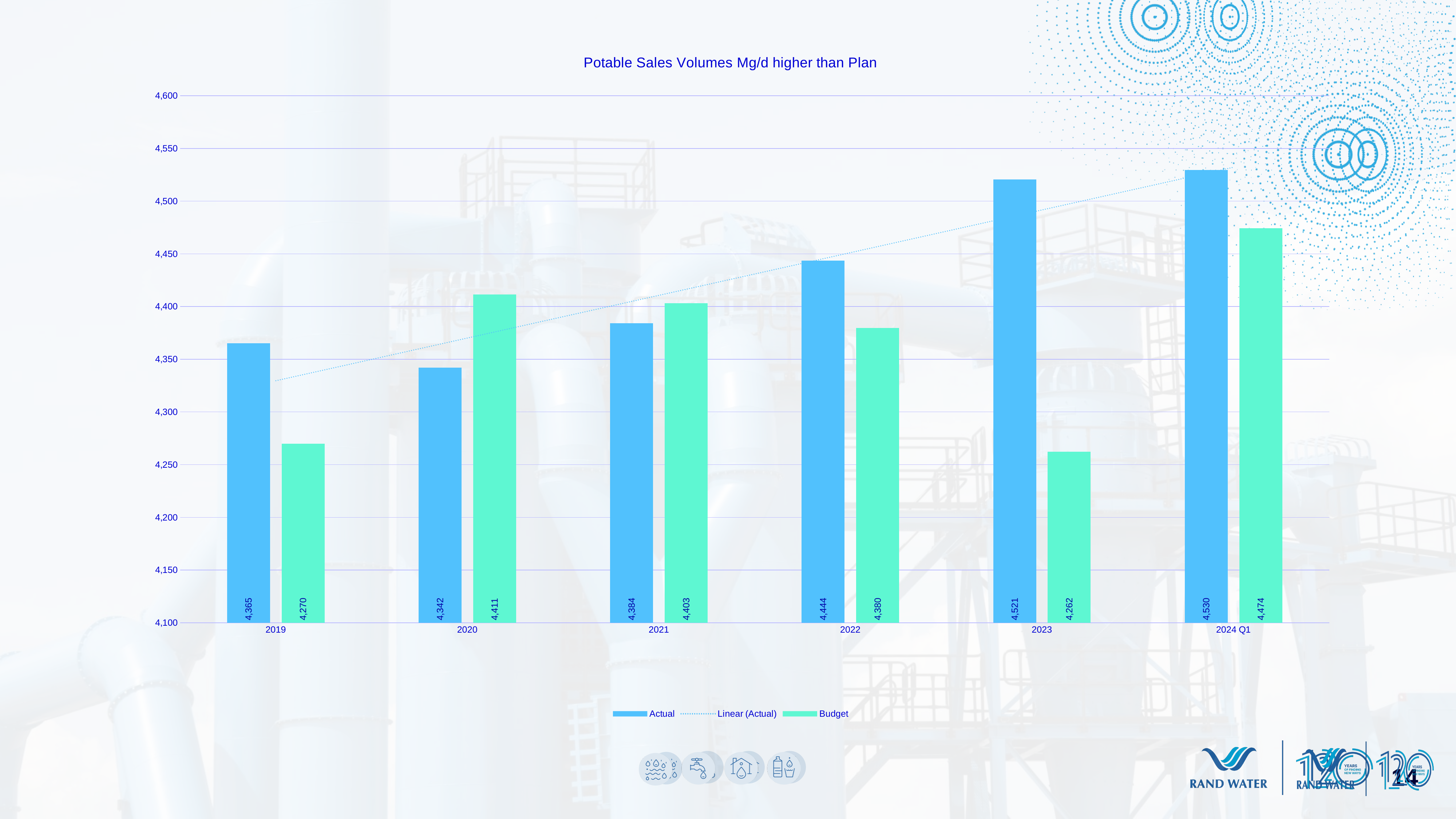
What kind of chart is shown on the slide? bar chart Which is larger for 2021, the Actual value or the Budget value? Budget What is the difference between the Actual and Budget values for 2023? 259 Is the Actual value for 2019 greater or less than 4,350? greater What is the Budget value for 2020? 4,411 What is the Actual value for 2024 Q1? 4,530 What is the Actual value for 2022? 4,444 Which category has the highest Actual value? 2024 Q1 Which category has the lowest Budget value? 2023 How many entries does the legend list? 3 What is the title of the chart? Potable Sales Volumes Mg/d higher than Plan How many categories are shown on the x axis? 6